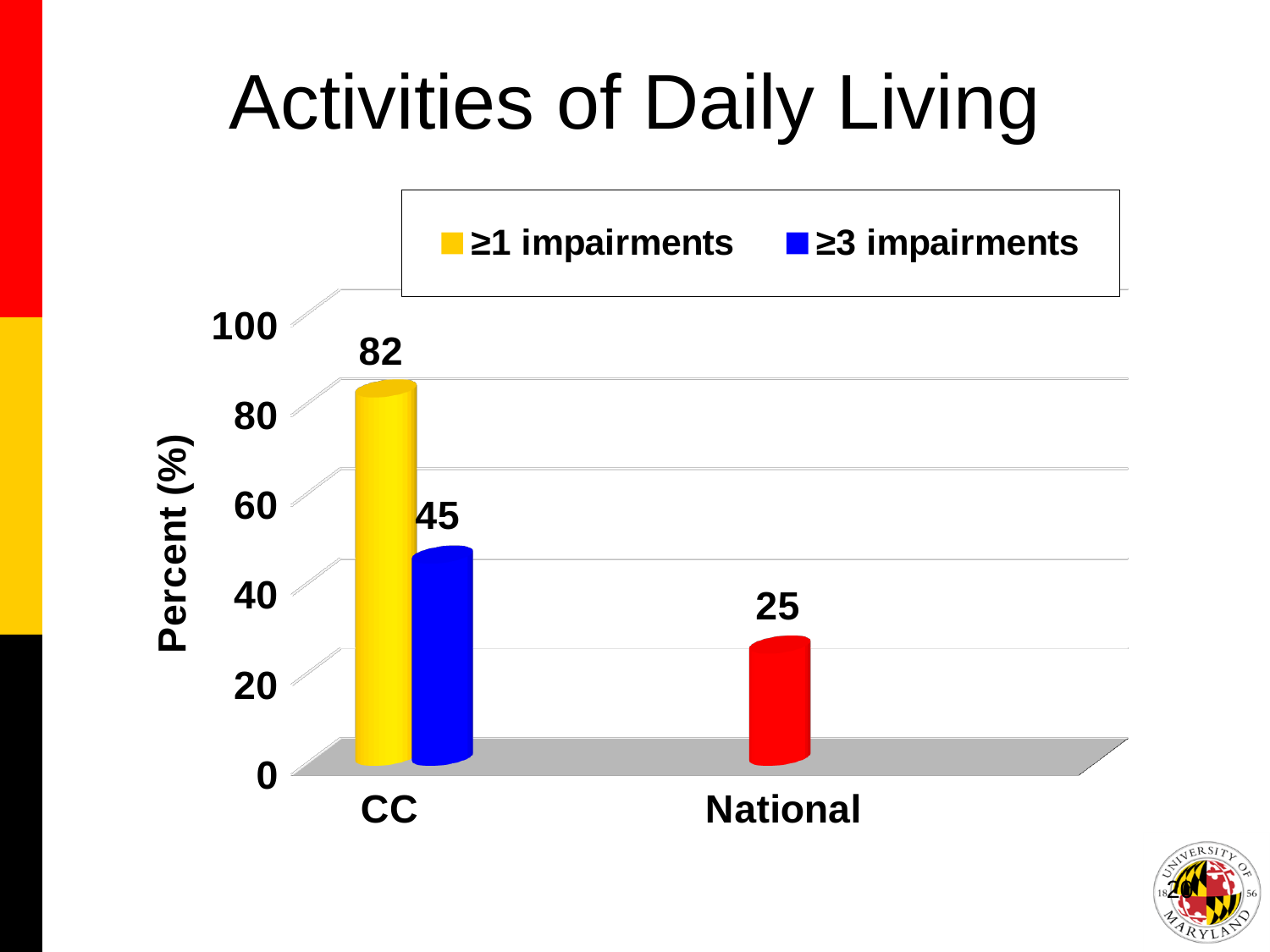
Which labelled bar on the chart has the lowest value? National (25) Which is larger: the ≥3 impairments value for CC or the value shown for National? ≥3 impairments for CC What kind of chart is shown on the slide? Bar chart What value is shown for ≥3 impairments in the CC category? 45 What value is shown for ≥1 impairments in the CC category? 82 Is the ≥1 impairments value for CC greater or less than 80? greater Which bar on the chart has the highest value? ≥1 impairments for CC (82) How many categories are shown on the x axis? 2 What is the difference between the ≥1 impairments and ≥3 impairments values for CC? 37 What is the difference between the ≥3 impairments value for CC and the value shown for National? 20 How many series does the legend list? 2 What value is labelled on the bar for the National category? 25